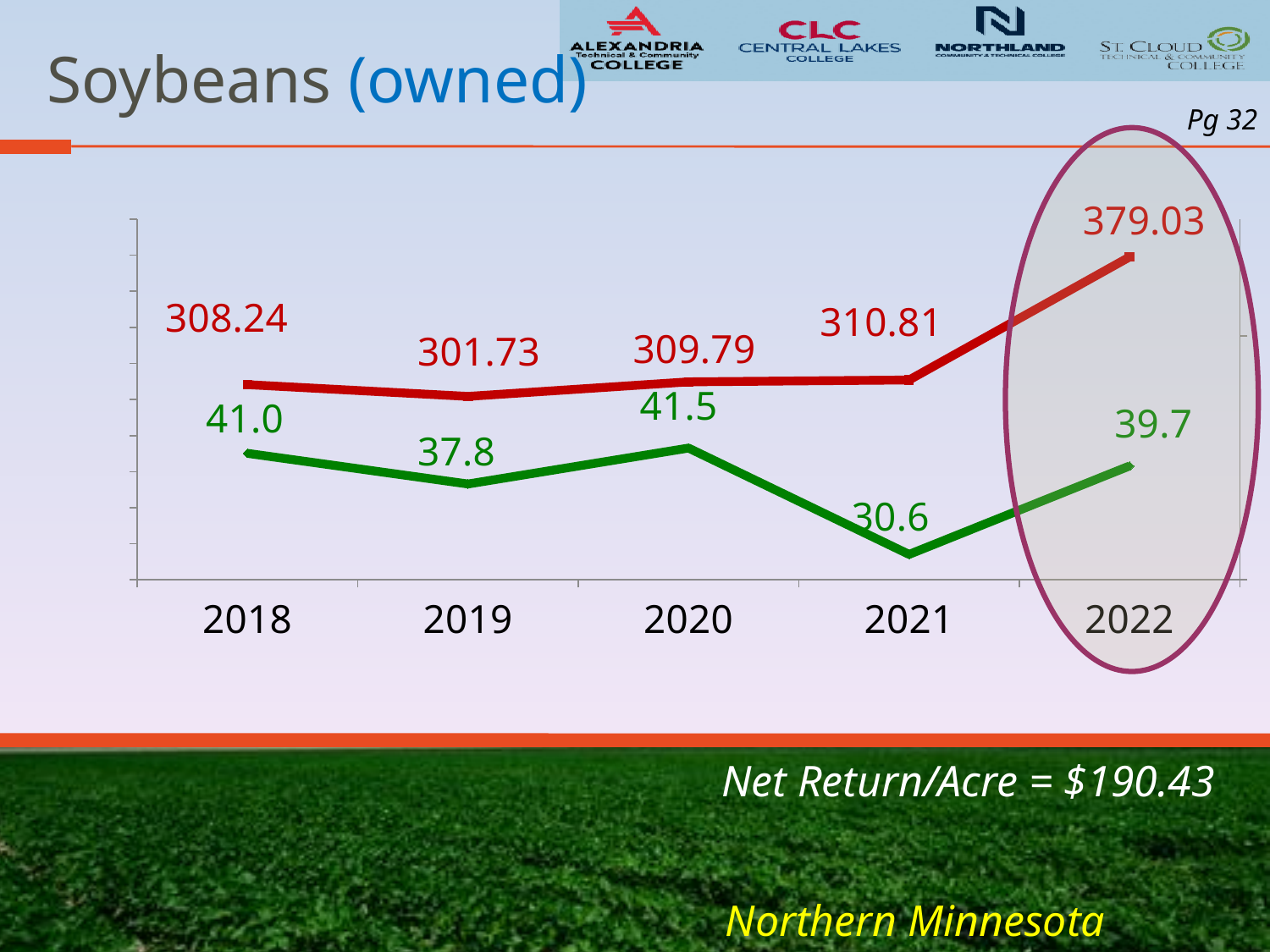
What is the value of the red line in 2022? 379.03 How many years are plotted on the x axis? 5 Which is larger for the green line: the 2019 value or the 2022 value? 2022 What is the value of the green line in 2021? 30.6 In which year does the green line reach its lowest value? 2021 In which year does the red line reach its highest value? 2022 Which year on the chart is circled? 2022 What is the value of the red line in 2019? 301.73 What is the value of the green line in 2018? 41.0 What type of chart is shown on the slide? line chart What is the difference between the red line's 2022 value and its 2021 value? 68.22 In which year does the green line reach its highest value? 2020